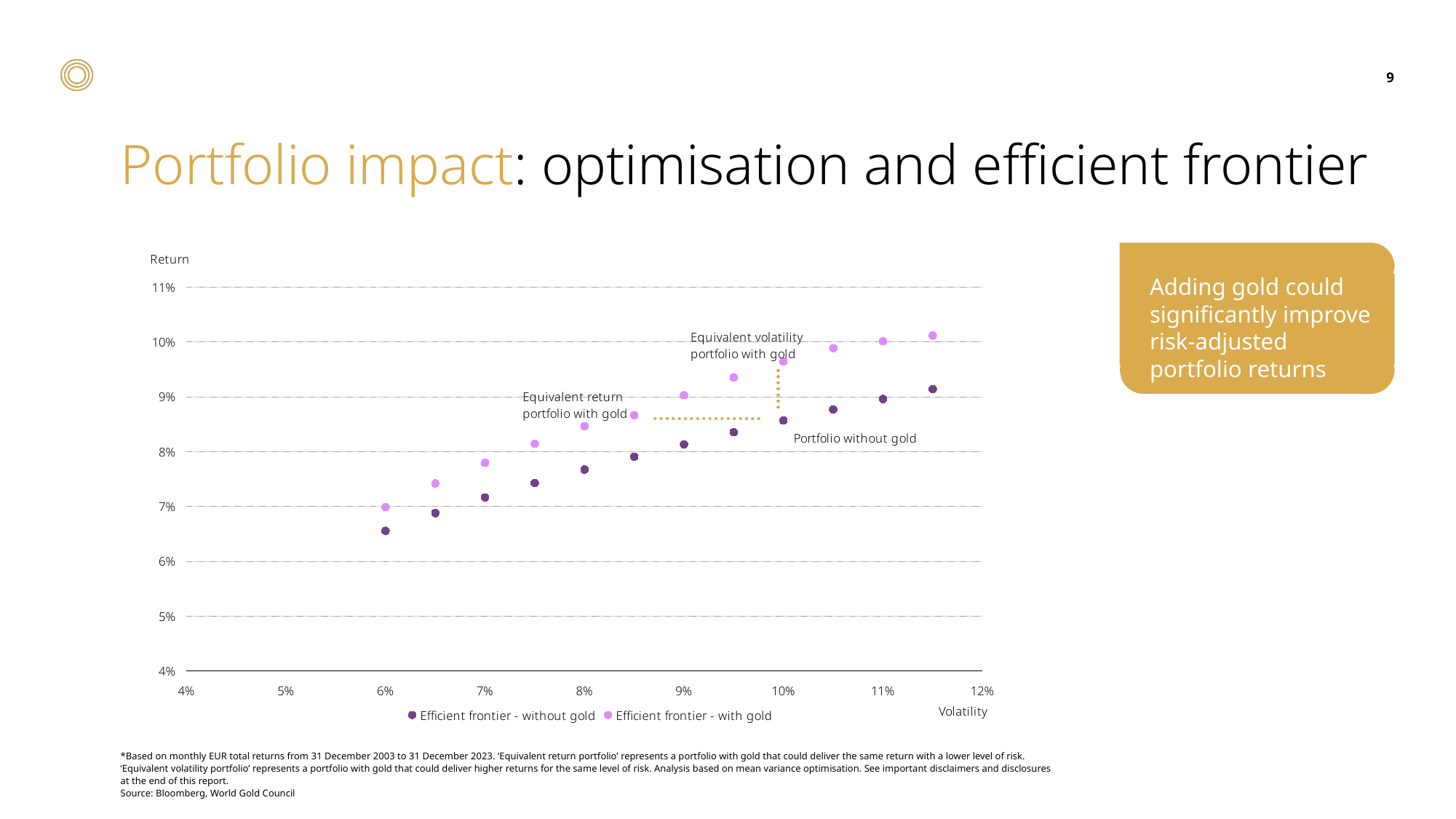
What kind of chart is shown on the slide? Scatter chart What are the two series named in the legend? Efficient frontier - without gold; Efficient frontier - with gold Do returns rise or fall as volatility increases along the x axis? Rise Is the return for the without-gold portfolio at 6% volatility greater or less than 7%? less Is the return for the without-gold portfolio at 10% volatility greater or less than 9%? less What label is given to the horizontal axis? Volatility How many points are plotted for the 'Efficient frontier - without gold' series? 12 How many series does the legend list? 2 Is the return for the with-gold portfolio at 8% volatility greater or less than 8%? greater At 10% volatility, which series has the higher return: with gold or without gold? Efficient frontier - with gold Which series contains the point with the highest return on the chart? Efficient frontier - with gold